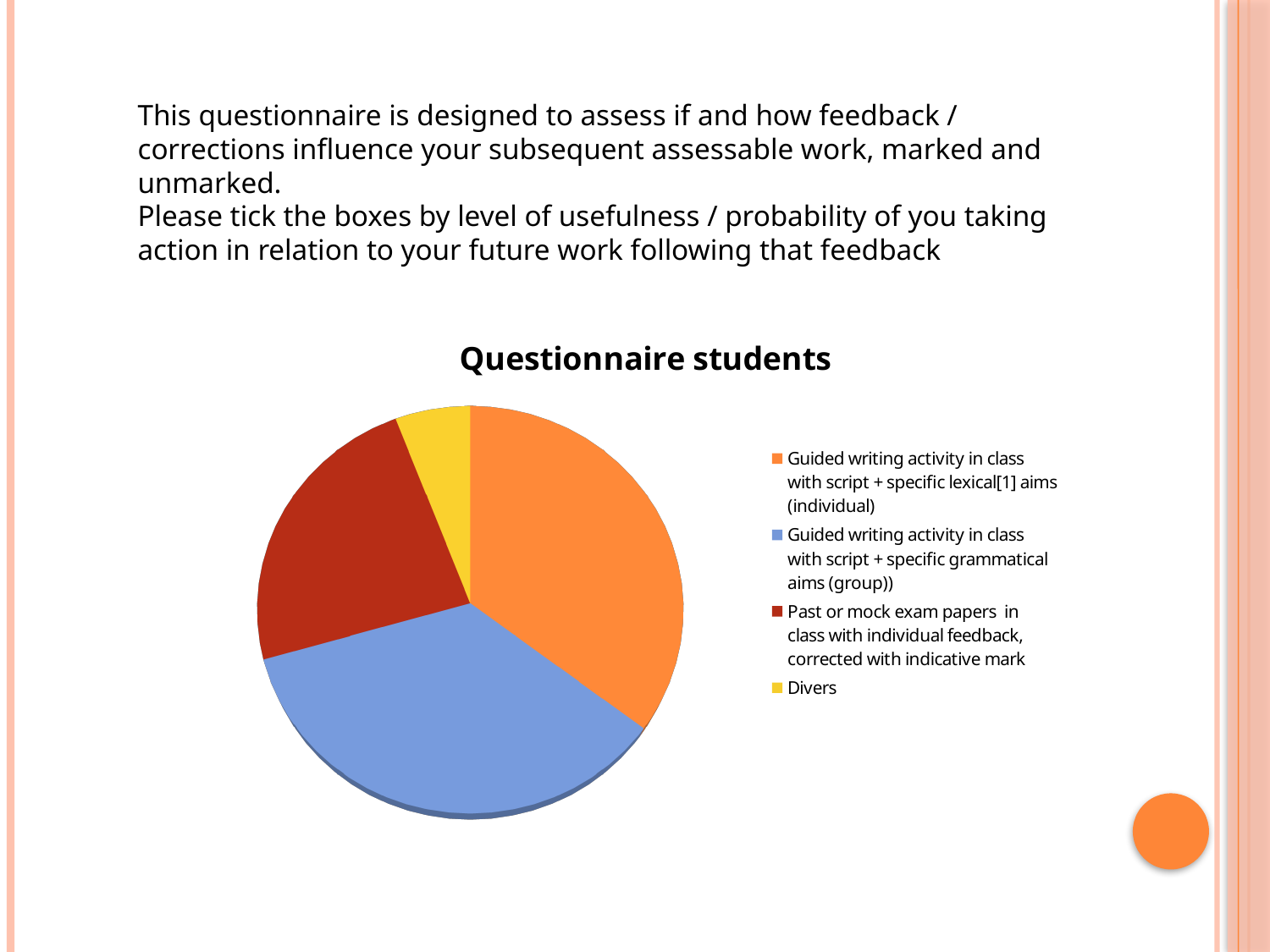
Which slice is larger: 'Guided writing activity in class with script + specific lexical[1] aims (individual)' or 'Past or mock exam papers in class with individual feedback, corrected with indicative mark'? Guided writing activity in class with script + specific lexical[1] aims (individual) What colour is the 'Divers' slice in the pie chart? yellow What kind of chart is shown on the slide? pie chart Which slice is larger: 'Past or mock exam papers in class with individual feedback, corrected with indicative mark' or 'Divers'? Past or mock exam papers in class with individual feedback, corrected with indicative mark What is the title of the chart? Questionnaire students How many slices does the pie chart have? 4 Which category has the smallest slice of the pie? Divers Which slice is larger: 'Guided writing activity in class with script + specific grammatical aims (group))' or 'Divers'? Guided writing activity in class with script + specific grammatical aims (group)) How many entries does the legend list? 4